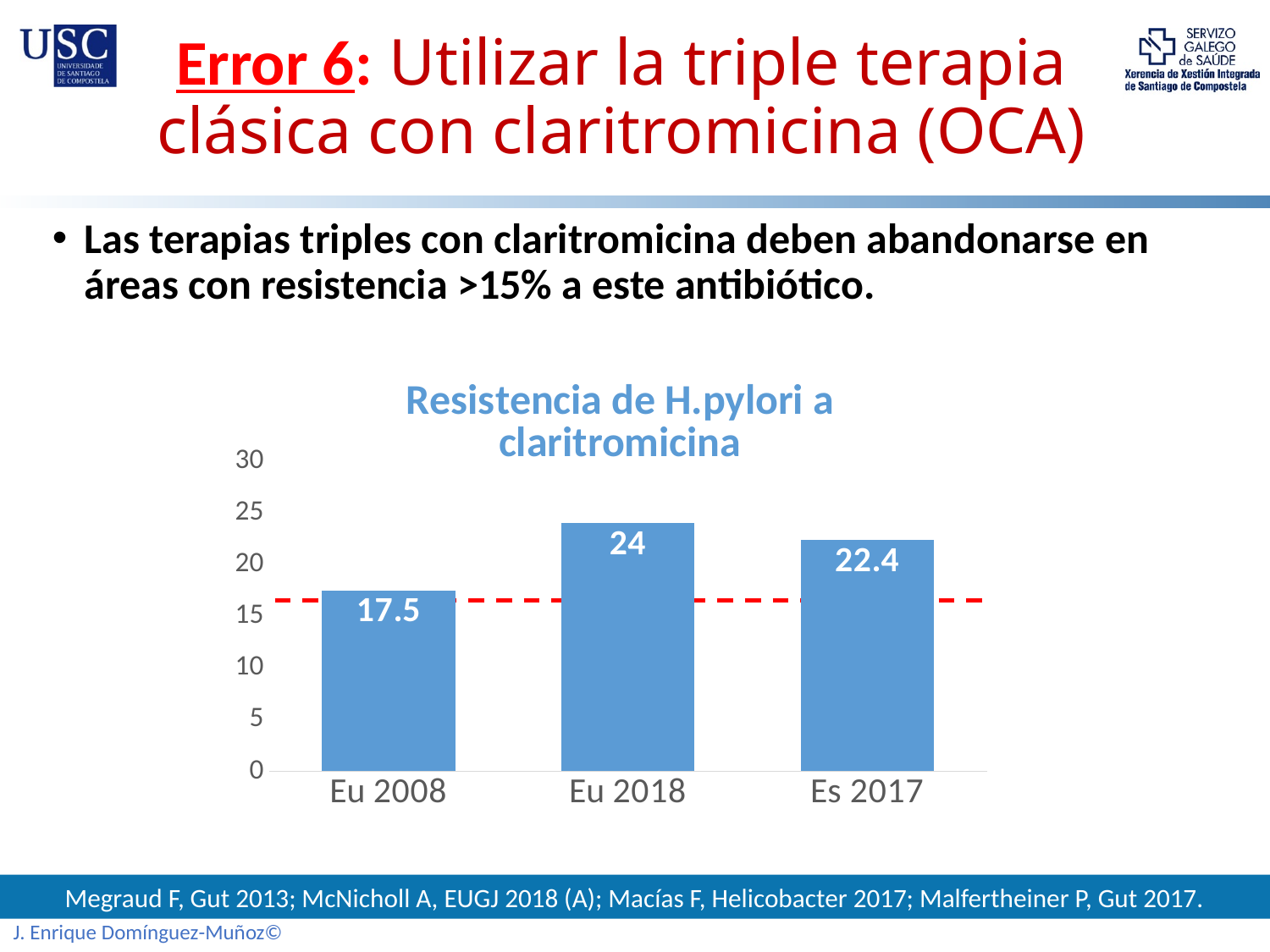
Which category has the lowest value? Eu 2008 Which category has the highest value? Eu 2018 What is the difference between the values for Eu 2018 and Eu 2008? 6.5 What kind of chart is shown on the slide? bar chart What is the value for Es 2017? 22.4 What is the value for Eu 2018? 24 Which is larger, the value for Es 2017 or the value for Eu 2008? Es 2017 What is the difference between the values for Eu 2018 and Es 2017? 1.6 What is the title of the chart? Resistencia de H.pylori a claritromicina Is the value for Eu 2008 greater or less than 20? less How many categories are shown on the x axis? 3 What is the value for Eu 2008? 17.5